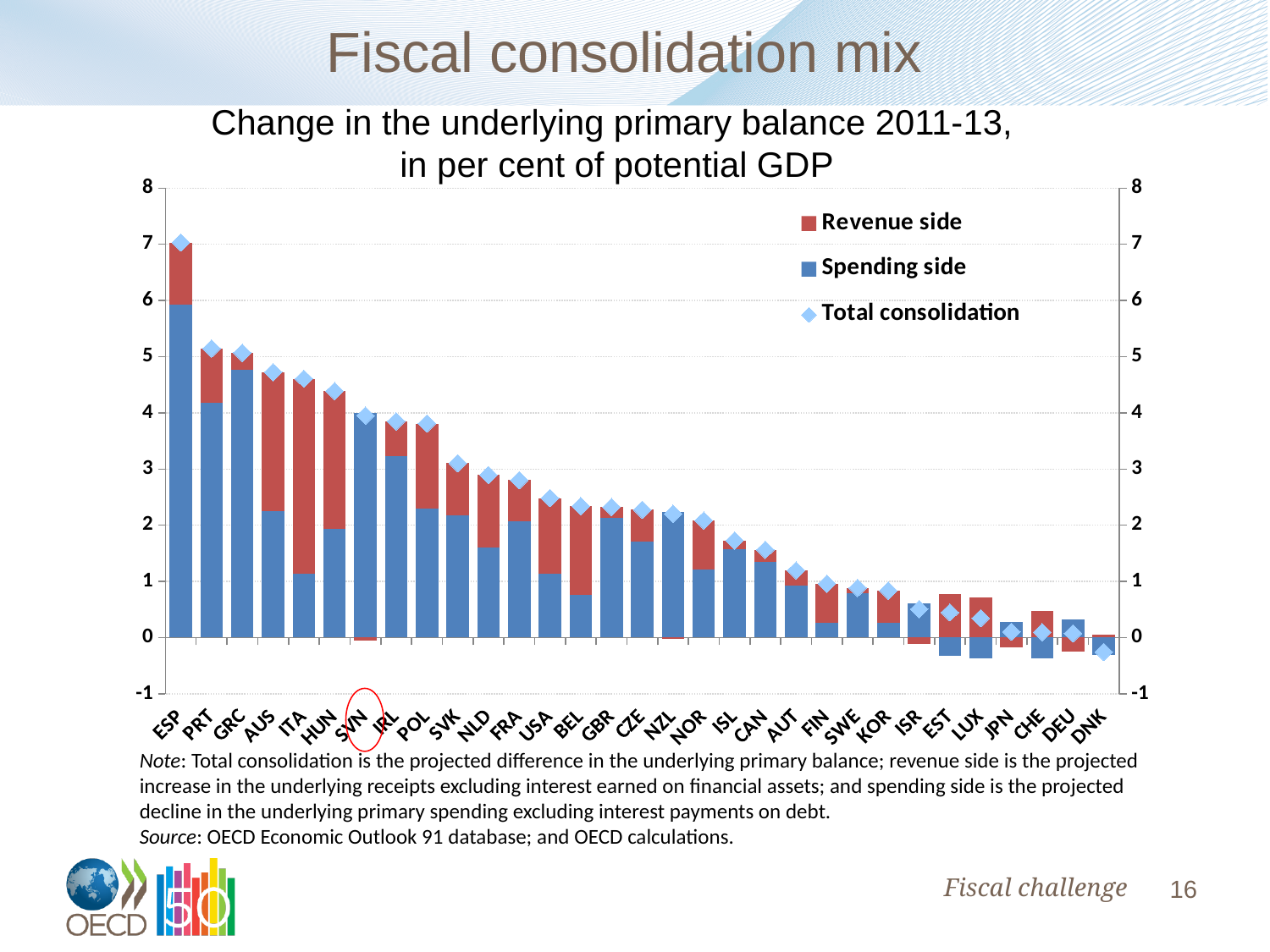
Which has the larger spending side value, ITA or HUN? HUN Is the total consolidation for ESP greater or less than 6? greater Is the spending side value for BEL greater or less than 1? less How many countries are shown on the x axis of the chart? 31 Which country has the highest total consolidation? ESP How many series does the chart legend list? 3 Which country label on the x axis is circled in red? SVN What kind of chart is shown on the slide? bar chart Do the total consolidation values rise or fall moving from left to right along the x axis? fall Is the spending side value for IRL greater or less than 3? greater Which country has the lowest total consolidation? DNK Which country has the largest revenue side contribution? ITA